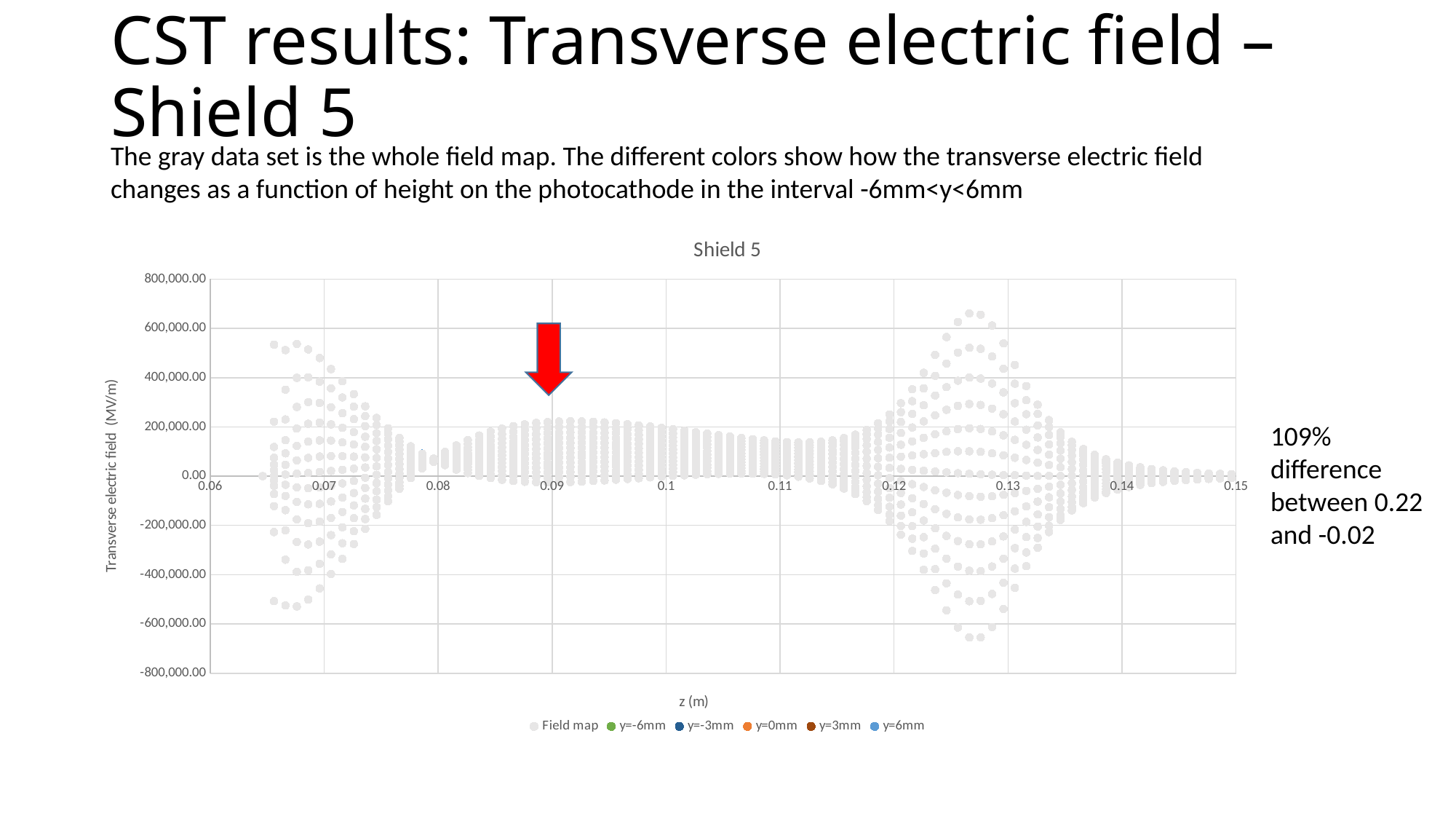
Which has the larger peak Field map value: the cluster near z = 0.07 or the cluster near z = 0.13? z = 0.13 Is the highest Field map value near z = 0.07 greater or less than 600,000.00? less Is the lowest Field map value near z = 0.13 greater or less than -600,000.00? less What kind of chart is shown on the slide? Scatter chart Is the highest Field map value near z = 0.09 greater or less than 400,000.00? less How many series does the chart legend list? 6 What is the label of the x axis of the chart? z (m) What is the title of the chart? Shield 5